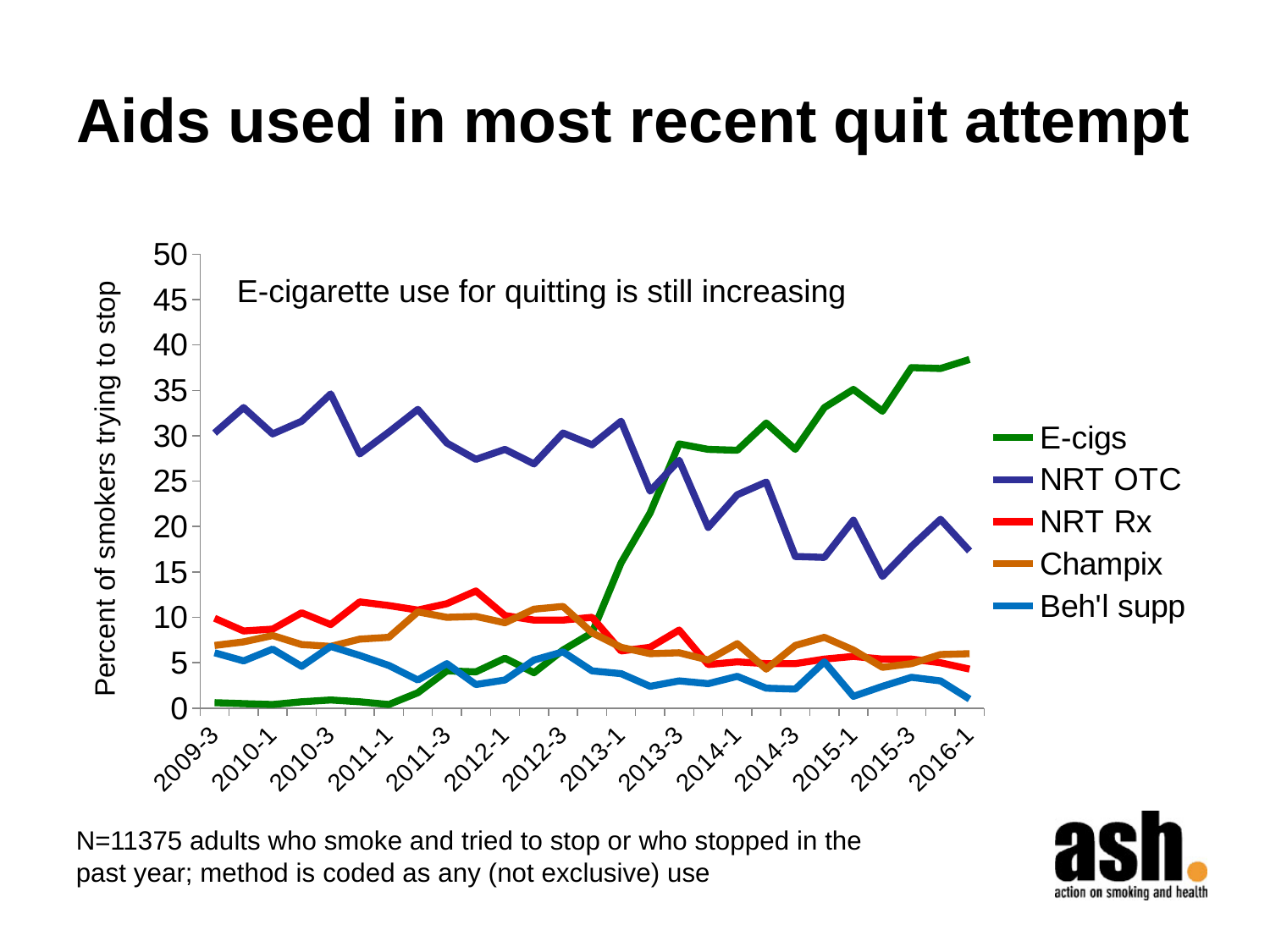
How many series does the legend list? 5 What kind of chart is shown on the slide? line chart Does the E-cigs line rise or fall overall from 2009-3 to 2016-1? rise Is the value for E-cigs at 2009-3 greater or less than 5? less At 2009-3, which is larger: NRT OTC or NRT Rx? NRT OTC What is the label on the vertical axis? Percent of smokers trying to stop Which series has the highest value at 2016-1? E-cigs At 2016-1, which is larger: E-cigs or NRT OTC? E-cigs Is the value for E-cigs at 2016-1 greater or less than 35? greater Is the value for NRT OTC at 2016-1 greater or less than 20? less Does the NRT OTC line rise or fall overall from 2009-3 to 2016-1? fall